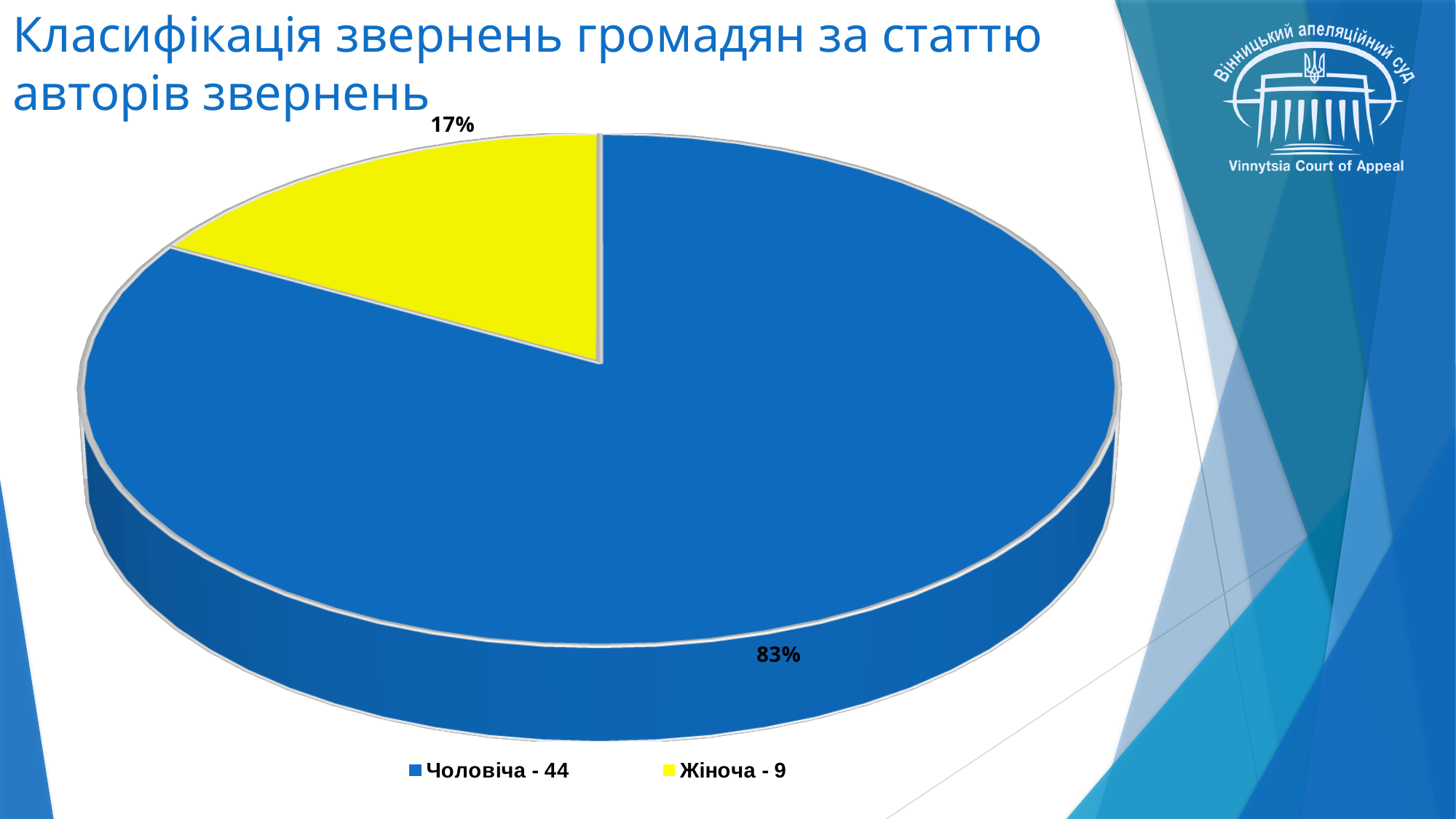
How many slices does the pie chart have? 2 Which category has the largest slice of the pie? Чоловіча What colour is the Жіноча slice? Yellow What percentage share does the Жіноча slice have? 17% Which is larger, the Чоловіча slice or the Жіноча slice? Чоловіча Which category has the smallest slice of the pie? Жіноча What is the difference in percentage points between the Чоловіча and Жіноча slices? 66 What count is shown for Жіноча in the legend? 9 What count is shown for Чоловіча in the legend? 44 What kind of chart is shown on the slide? Pie chart What percentage share does the Чоловіча slice have? 83% What is the difference between the Чоловіча and Жіноча counts shown in the legend? 35